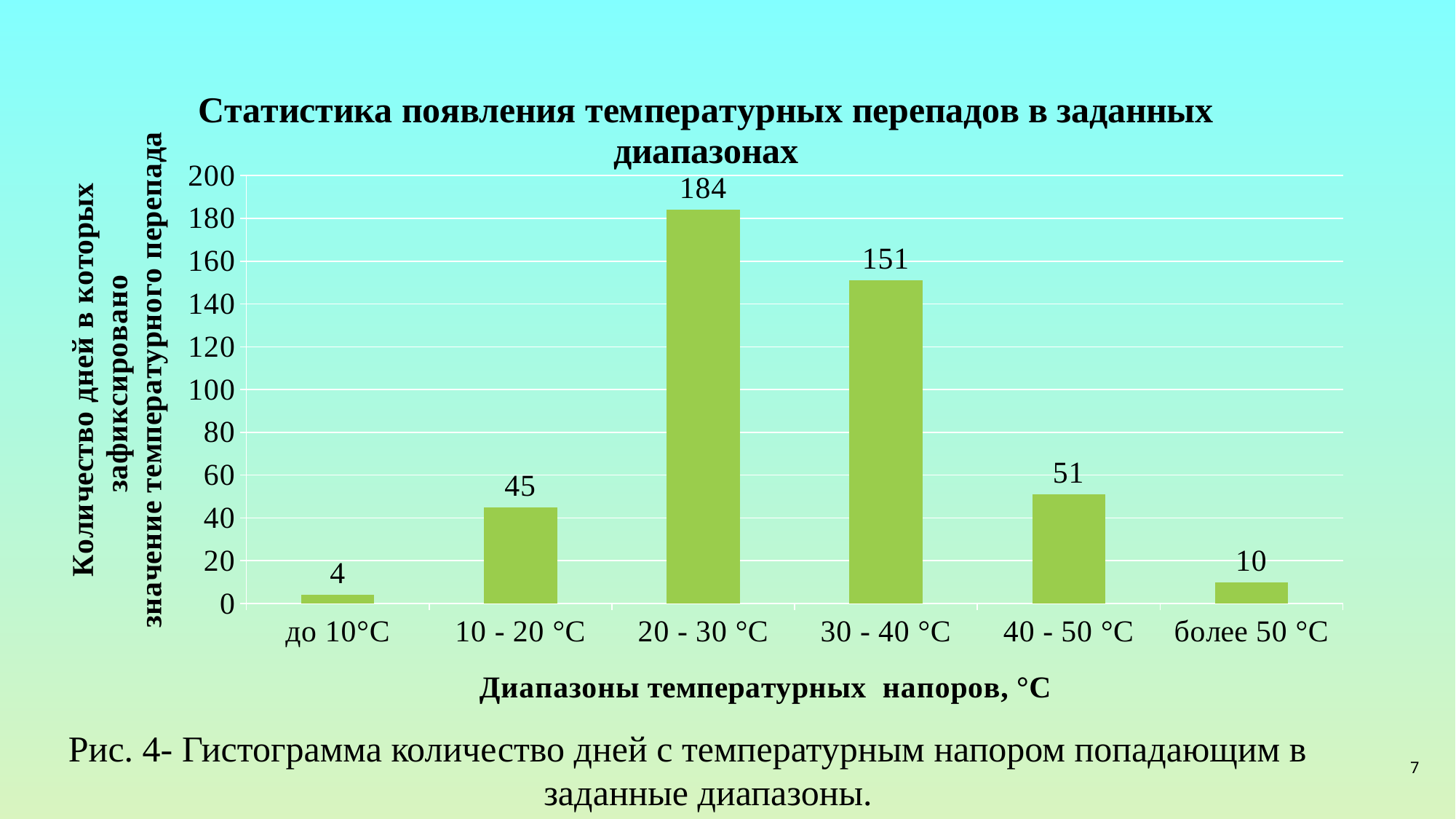
How many categories are shown on the x axis? 6 What is the value for the "до 10°C" category? 4 What is the x-axis title of the chart? Диапазоны температурных напоров, °C What is the value for the "более 50 °C" category? 10 Which is larger: the value for "10 - 20 °C" or the value for "40 - 50 °C"? 40 - 50 °C What is the value for the "20 - 30 °C" category? 184 Is the value for "30 - 40 °C" greater or less than 140? greater What is the difference between the values for "40 - 50 °C" and "10 - 20 °C"? 6 Which category has the lowest value? до 10°C Which category has the highest value? 20 - 30 °C What kind of chart is shown on the slide? bar chart What is the difference between the values for "20 - 30 °C" and "30 - 40 °C"? 33